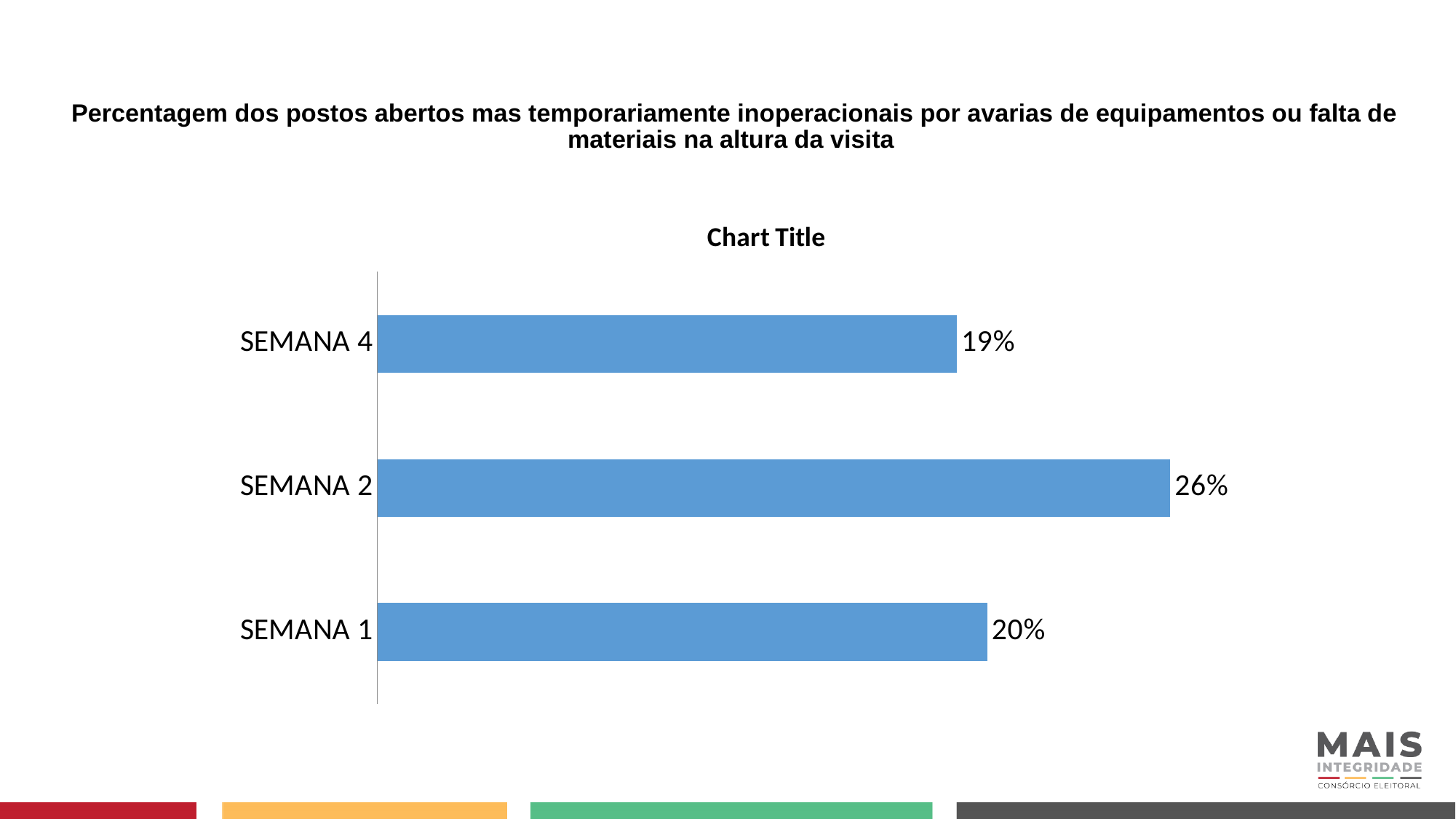
What is the difference between the values for SEMANA 2 and SEMANA 4? 7% What colour are the bars in the chart? Blue Which category has the lowest value? SEMANA 4 What is the value for SEMANA 4? 19% What is the value for SEMANA 2? 26% What kind of chart is shown on the slide? Bar chart Which is larger, the value for SEMANA 2 or the value for SEMANA 1? SEMANA 2 What is the difference between the values for SEMANA 1 and SEMANA 4? 1% How many categories are shown in the chart? 3 What is the title printed directly above the chart? Chart Title Which category has the highest value? SEMANA 2 What is the value for SEMANA 1? 20%